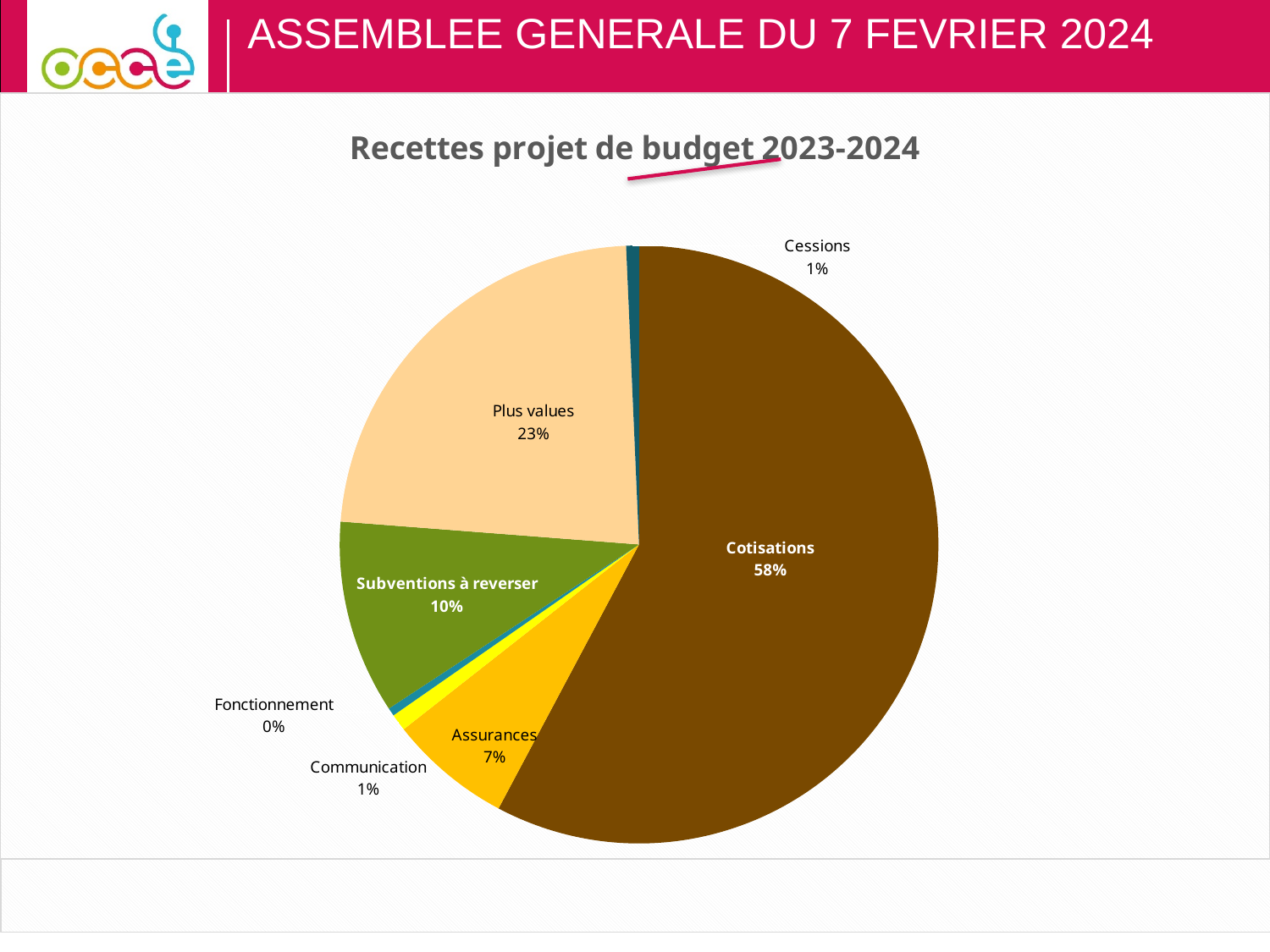
What percentage is shown for Plus values? 23% What share of the pie does Cotisations represent? 58% What is the difference in percentage points between Cotisations and Plus values? 35 How many categories are shown in the pie chart? 7 What percentage is shown for Fonctionnement? 0% Which is larger, Subventions à reverser or Assurances? Subventions à reverser What percentage is shown for Assurances? 7% Which category has the largest slice of the pie? Cotisations What type of chart is shown on the slide? Pie chart What is the value labelled for Subventions à reverser? 10% What is the title of the chart? Recettes projet de budget 2023-2024 Which category has the smallest share of the pie? Fonctionnement